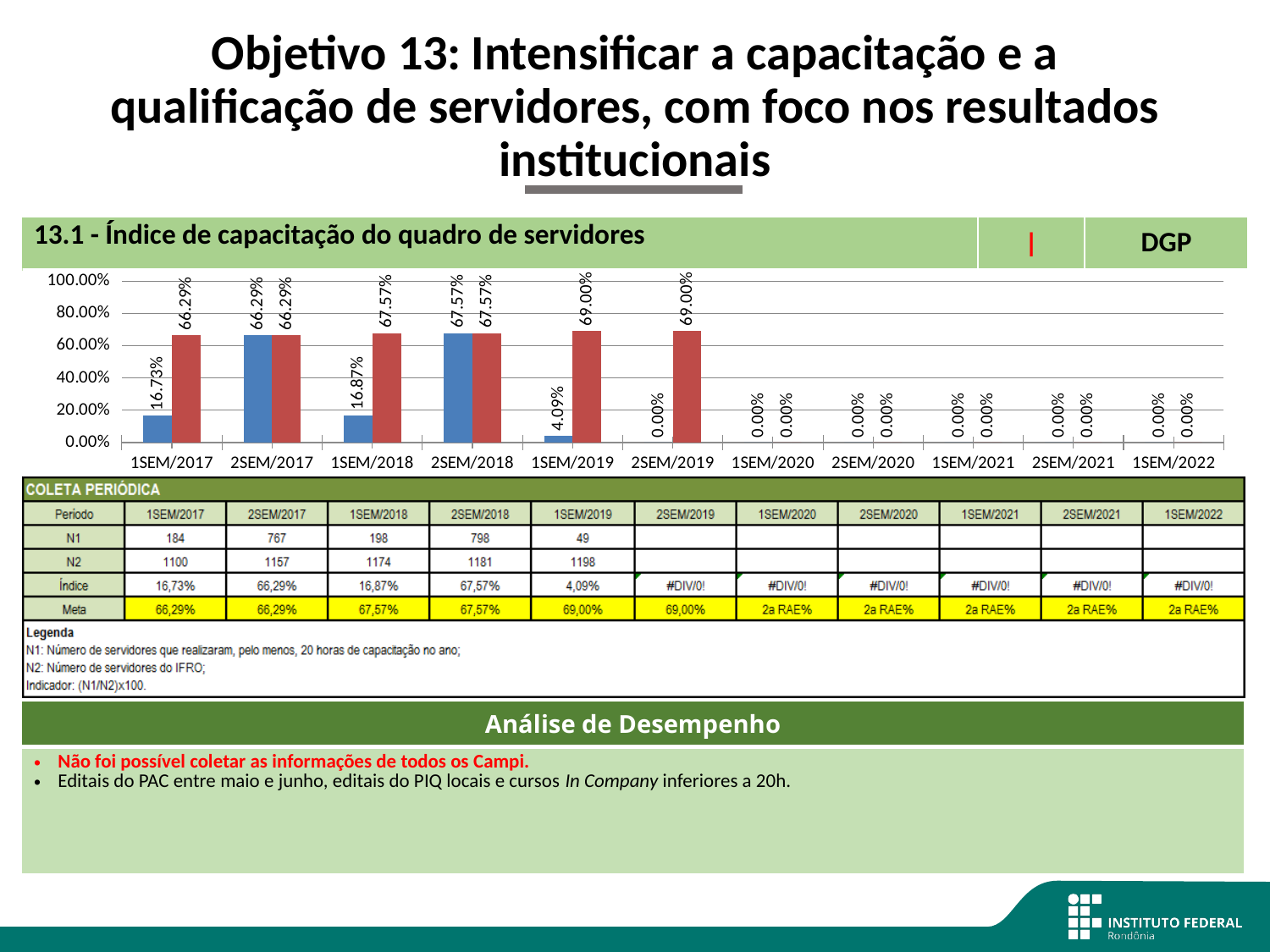
What is the difference between the red bar and the blue bar for 1SEM/2018? 50.70% What is the value of the red bar for 1SEM/2018? 67.57% What is the value of the red bar for 1SEM/2019? 69.00% Is the blue bar value for 2SEM/2018 greater or less than 60.00%? greater What is the value of the blue bar for 1SEM/2017? 16.73% What kind of chart is shown under "13.1 - Índice de capacitação do quadro de servidores"? bar chart How many periods are shown on the x axis of the chart? 11 What is the value of the blue bar for 1SEM/2019? 4.09% Which period has the highest blue bar value? 2SEM/2018 What is the value of the blue bar for 2SEM/2019? 0.00% Which of the blue bars is larger, 1SEM/2017 or 2SEM/2017? 2SEM/2017 What is the highest tick value shown on the y axis of the chart? 100.00%